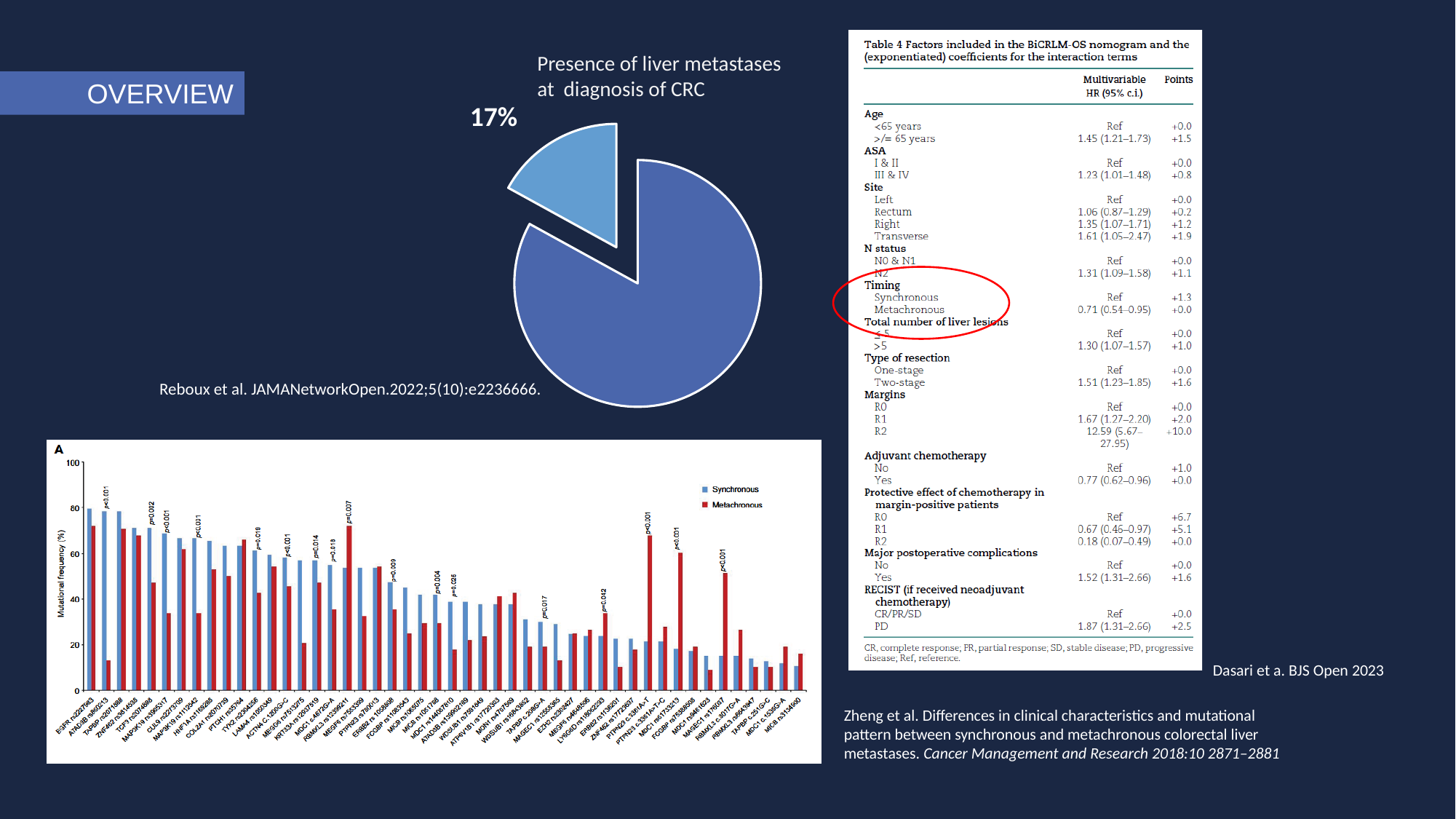
In the pie chart 'Presence of liver metastases at diagnosis of CRC', which slice is larger, the dark blue one or the light blue one? the dark blue one What kind of chart is the chart at the bottom left of the slide (panel A, mutational frequency)? bar chart In the pie chart titled 'Presence of liver metastases at diagnosis of CRC', what percentage is shown for the smaller, light blue slice? 17% What are the two series named in the legend of the bottom-left bar chart (panel A)? Synchronous and Metachronous In the bottom-left bar chart (panel A), which colour represents the Metachronous series? red In the bottom-left bar chart (panel A), is the Synchronous value for the first category on the left (EGFR rs2227983) greater or less than 60? greater In the bottom-left bar chart (panel A), what is the label of the y axis? Mutational frequency (%) What kind of chart is the chart titled 'Presence of liver metastases at diagnosis of CRC'? pie chart How many series does the legend of the bottom-left bar chart (panel A) list? 2 How many slices does the pie chart 'Presence of liver metastases at diagnosis of CRC' have? 2 In the bottom-left bar chart (panel A), do the Synchronous (blue) bars generally rise or fall from left to right along the x axis? fall In the bottom-left bar chart (panel A), for the first category on the left (EGFR rs2227983), which series has the higher value, Synchronous or Metachronous? Synchronous